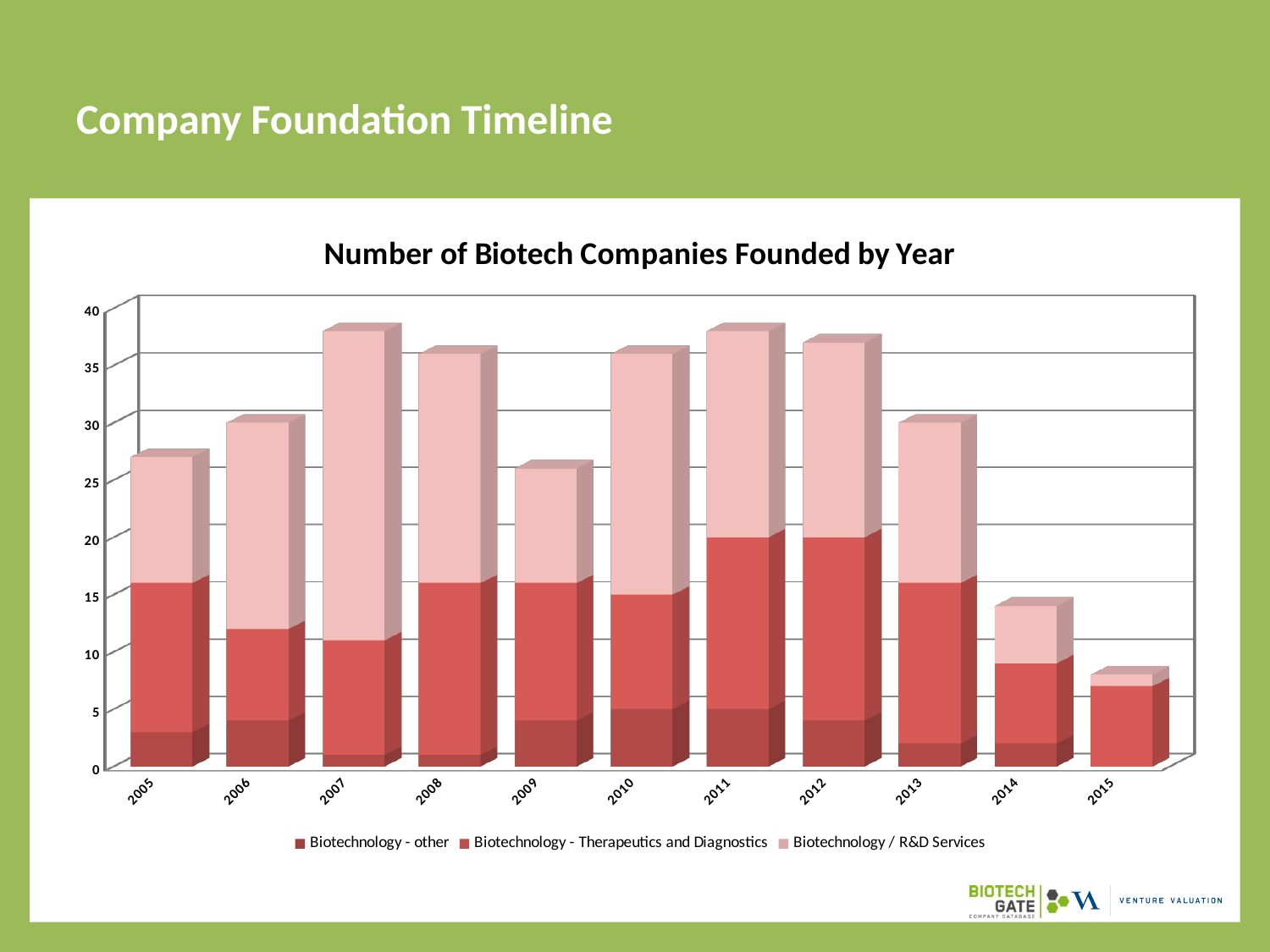
What is the title of the chart? Number of Biotech Companies Founded by Year Is the total value for 2015 greater or less than 10? less How many series does the legend list? 3 Is the total value for 2014 greater or less than 20? less Which year has a larger total, 2014 or 2015? 2014 How many years are shown on the x axis? 11 Is the total value for 2007 greater or less than 35? greater Which year has the lowest total number of biotech companies founded? 2015 Which year has a larger total, 2007 or 2009? 2007 What kind of chart is shown on the slide? Stacked bar chart Do the total values rise or fall from 2012 to 2015? fall